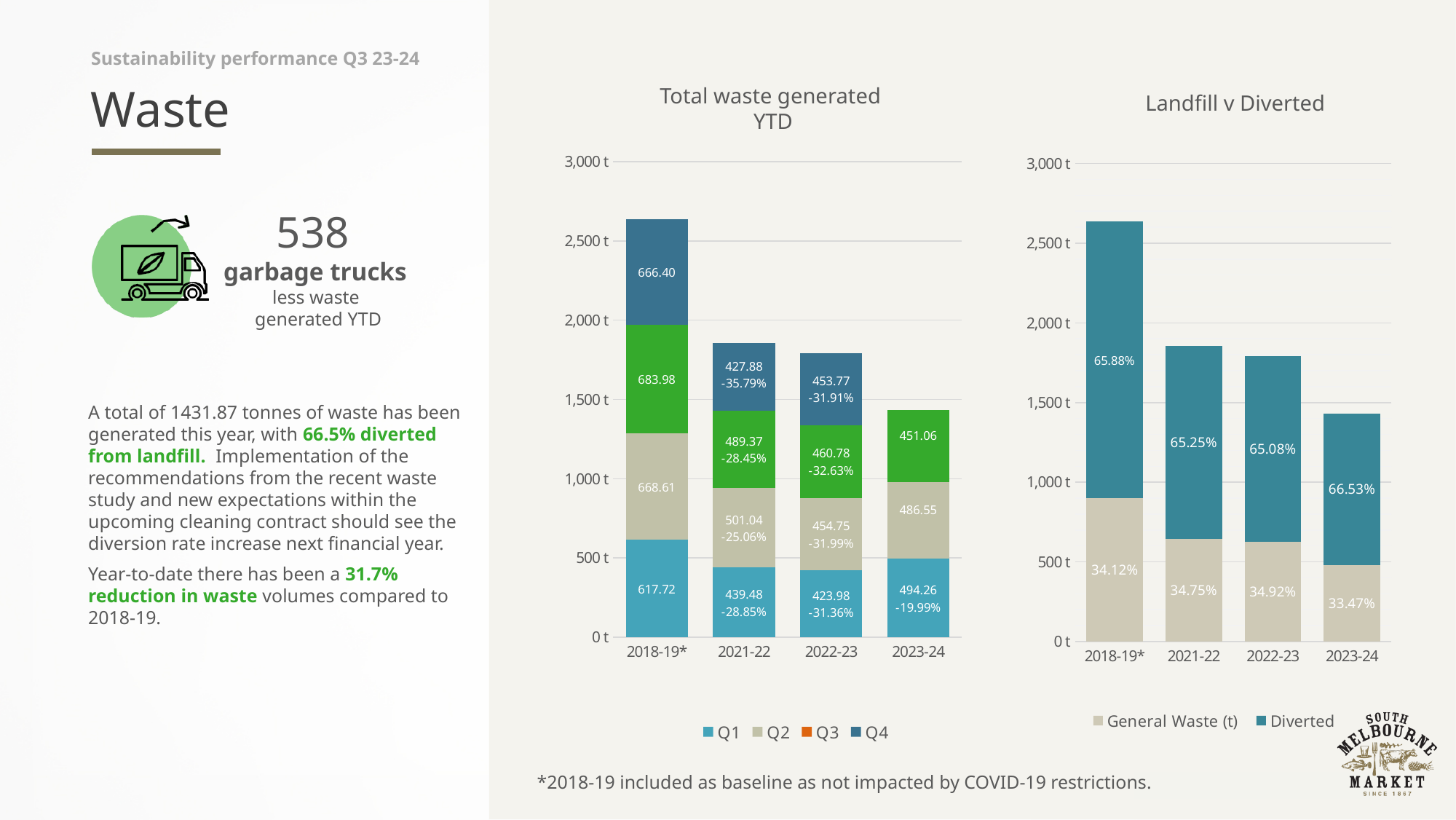
In the 'Total waste generated YTD' chart, what is the total of the stacked bar for 2023-24? 1431.87 How many series does the legend of the 'Total waste generated YTD' chart list? 4 In the 'Total waste generated YTD' chart, what is the Q1 value for 2018-19*? 617.72 In the 'Total waste generated YTD' chart, what is the Q4 value for 2021-22? 427.88 In the 'Total waste generated YTD' chart, what is the difference between the Q1 value for 2018-19* and the Q1 value for 2023-24? 123.46 In the 'Landfill v Diverted' chart, which year has the lowest General Waste percentage? 2023-24 What kind of chart is the 'Landfill v Diverted' chart? Stacked bar chart In the 'Landfill v Diverted' chart, which year has the highest Diverted percentage? 2023-24 In the 'Total waste generated YTD' chart, is the total bar for 2018-19* greater or less than 2,500 t? greater In the 'Landfill v Diverted' chart, what is the Diverted percentage for 2023-24? 66.53% How many years are shown on the x axis of the 'Total waste generated YTD' chart? 4 In the 'Total waste generated YTD' chart, which is larger: the Q2 value for 2021-22 or the Q2 value for 2022-23? 2021-22